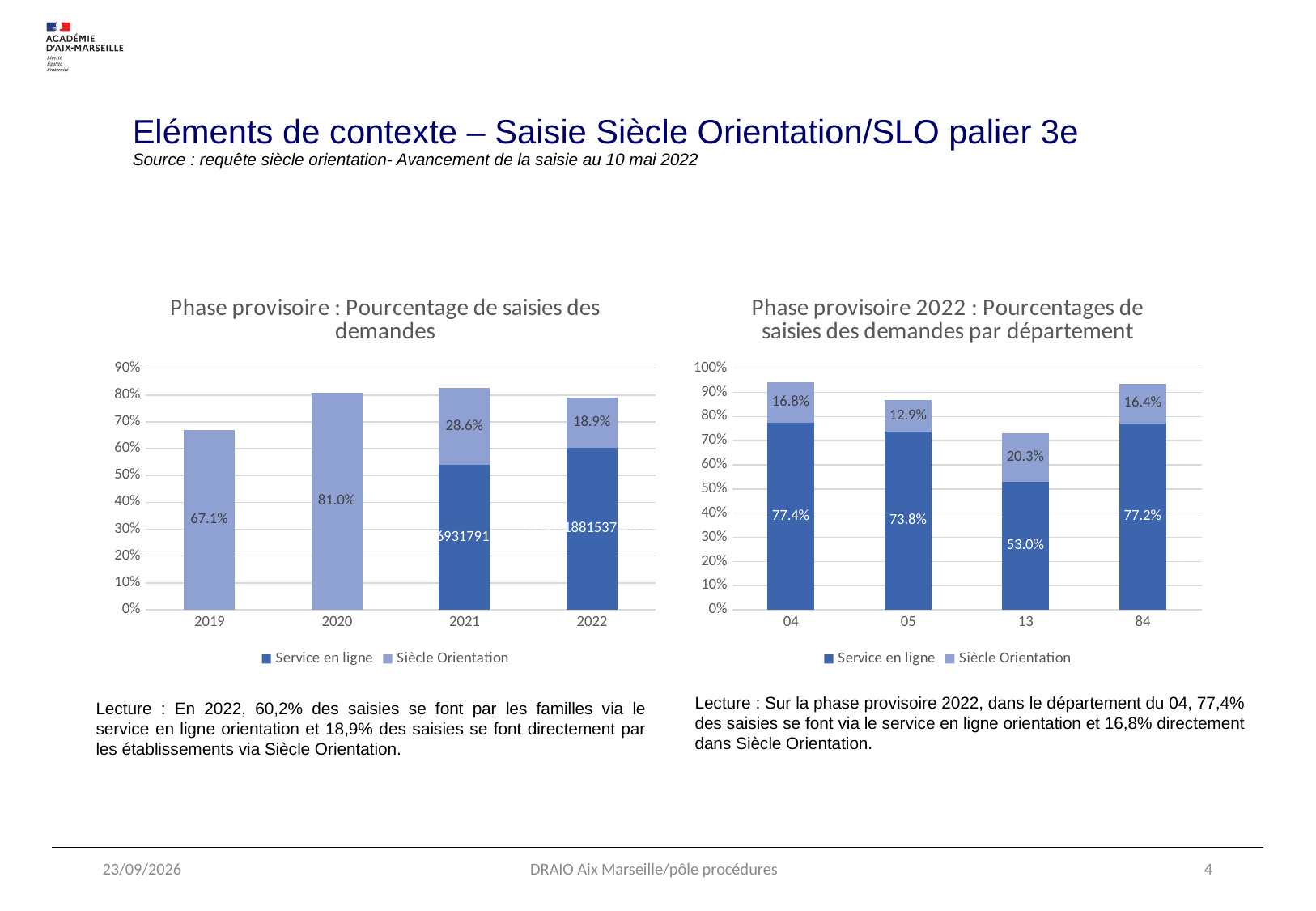
In the right chart 'Phase provisoire 2022 : Pourcentages de saisies des demandes par département', what is the Service en ligne value for département 04? 77.4% In the left chart 'Phase provisoire : Pourcentage de saisies des demandes', is the Service en ligne value for 2021 greater or less than 50%? greater In the left chart 'Phase provisoire : Pourcentage de saisies des demandes', what is the value for Siècle Orientation in 2020? 81.0% In the right chart 'Phase provisoire 2022 : Pourcentages de saisies des demandes par département', which département has the lowest Service en ligne value? 13 In the right chart 'Phase provisoire 2022 : Pourcentages de saisies des demandes par département', what is the difference between the Service en ligne values for départements 04 and 13? 24.4 percentage points In the left chart 'Phase provisoire : Pourcentage de saisies des demandes', how many years are shown on the x axis? 4 In the right chart 'Phase provisoire 2022 : Pourcentages de saisies des demandes par département', what is the total of the stacked bar for département 04? 94.2% In the right chart 'Phase provisoire 2022 : Pourcentages de saisies des demandes par département', how many series does the legend list? 2 What kind of chart is the left chart 'Phase provisoire : Pourcentage de saisies des demandes'? Stacked bar chart In the left chart 'Phase provisoire : Pourcentage de saisies des demandes', what is the value for Siècle Orientation in 2019? 67.1% In the right chart 'Phase provisoire 2022 : Pourcentages de saisies des demandes par département', which département has the highest Siècle Orientation value? 13 In the left chart 'Phase provisoire : Pourcentage de saisies des demandes', what is the value for Siècle Orientation in 2022? 18.9%